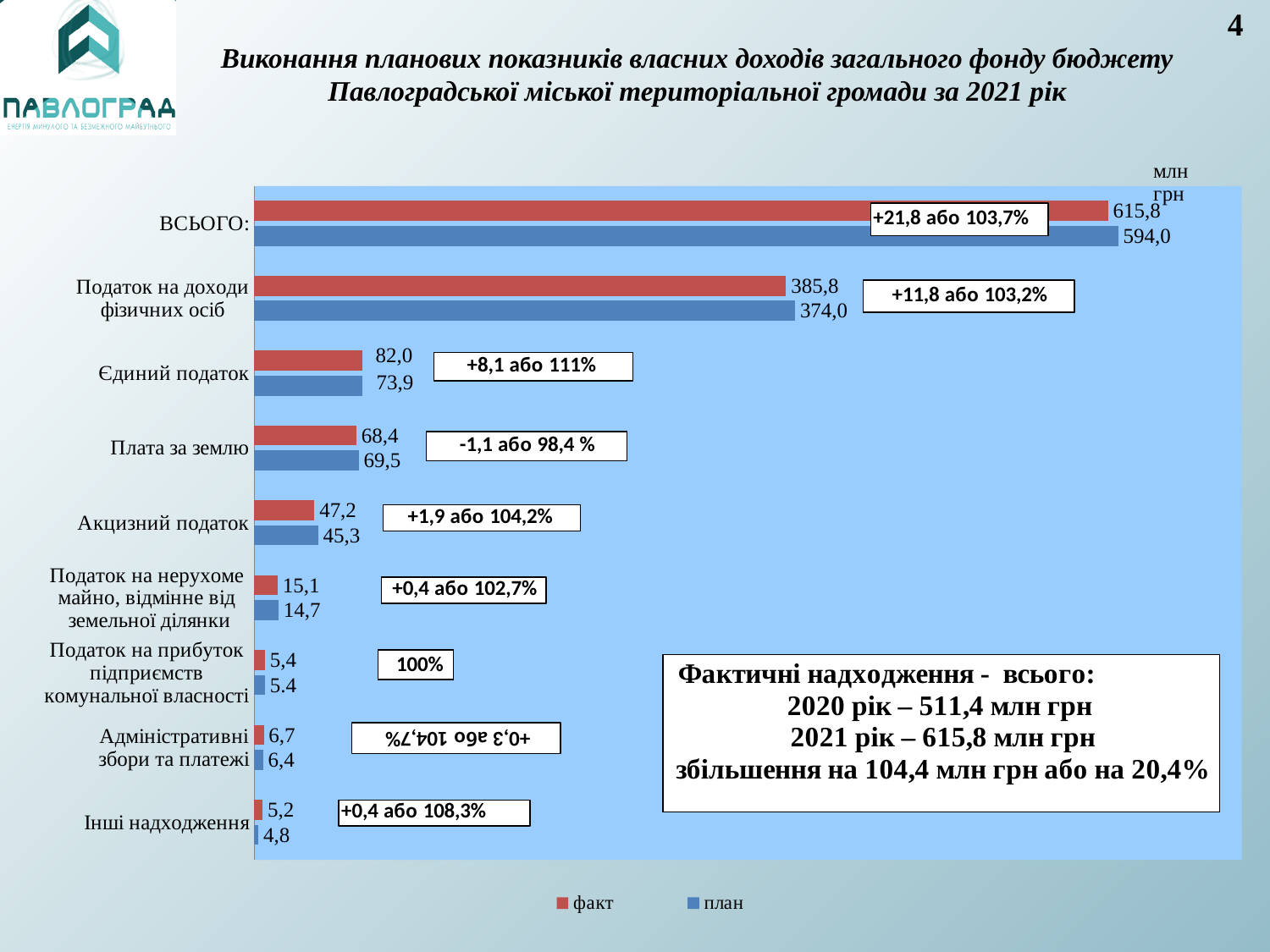
Which colour represents the факт series in the legend? red What is the план value for Плата за землю? 69,5 For Плата за землю, which is larger: the факт value or the план value? план How many categories are shown on the chart, including ВСЬОГО? 9 What is the difference between the факт and план values for ВСЬОГО? 21,8 How many series does the legend list? 2 What is the факт value for Єдиний податок? 82,0 What kind of chart is shown on the slide? bar chart What is the факт value for Акцизний податок? 47,2 Which category has the lowest план value? Інші надходження What is the план value for Податок на доходи фізичних осіб? 374,0 Excluding the ВСЬОГО total, which category has the highest факт value? Податок на доходи фізичних осіб